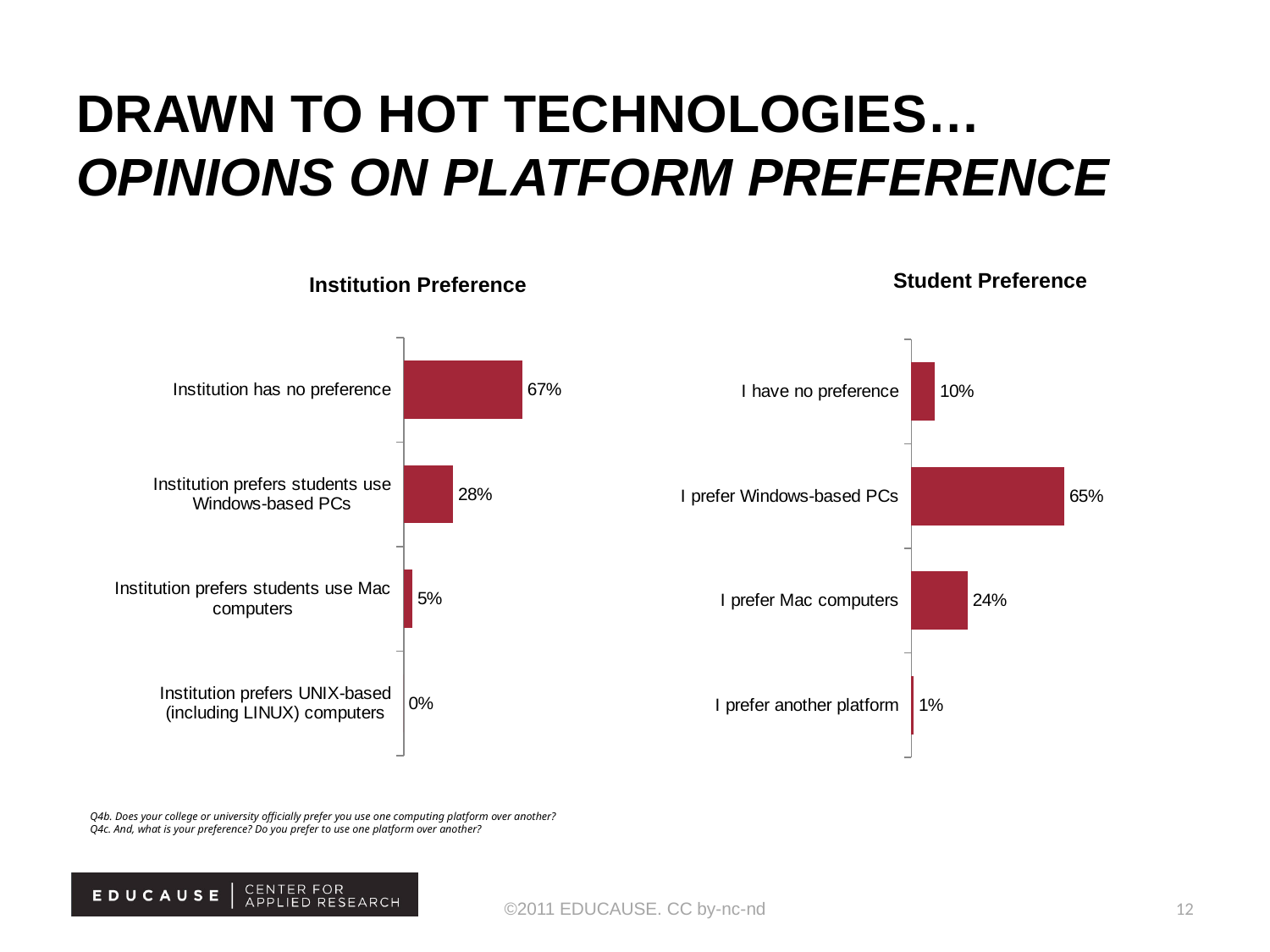
In the Institution Preference chart, what percentage is shown for "Institution has no preference"? 67% In the Institution Preference chart, which category has the lowest value? Institution prefers UNIX-based (including LINUX) computers In the Institution Preference chart, what is the difference between "Institution has no preference" and "Institution prefers students use Windows-based PCs"? 39% In the Student Preference chart, what percentage is shown for "I prefer another platform"? 1% In the Institution Preference chart, what percentage is shown for "Institution prefers students use Mac computers"? 5% In the Student Preference chart, what percentage is shown for "I prefer Windows-based PCs"? 65% In the Student Preference chart, which is larger: "I have no preference" or "I prefer Mac computers"? I prefer Mac computers What is the title of the chart on the left side of the slide? Institution Preference In the Student Preference chart, which category has the highest value? I prefer Windows-based PCs How many categories does the Institution Preference chart show? 4 In the Student Preference chart, what is the difference between "I prefer Windows-based PCs" and "I prefer Mac computers"? 41% What kind of chart is the Student Preference chart? Bar chart